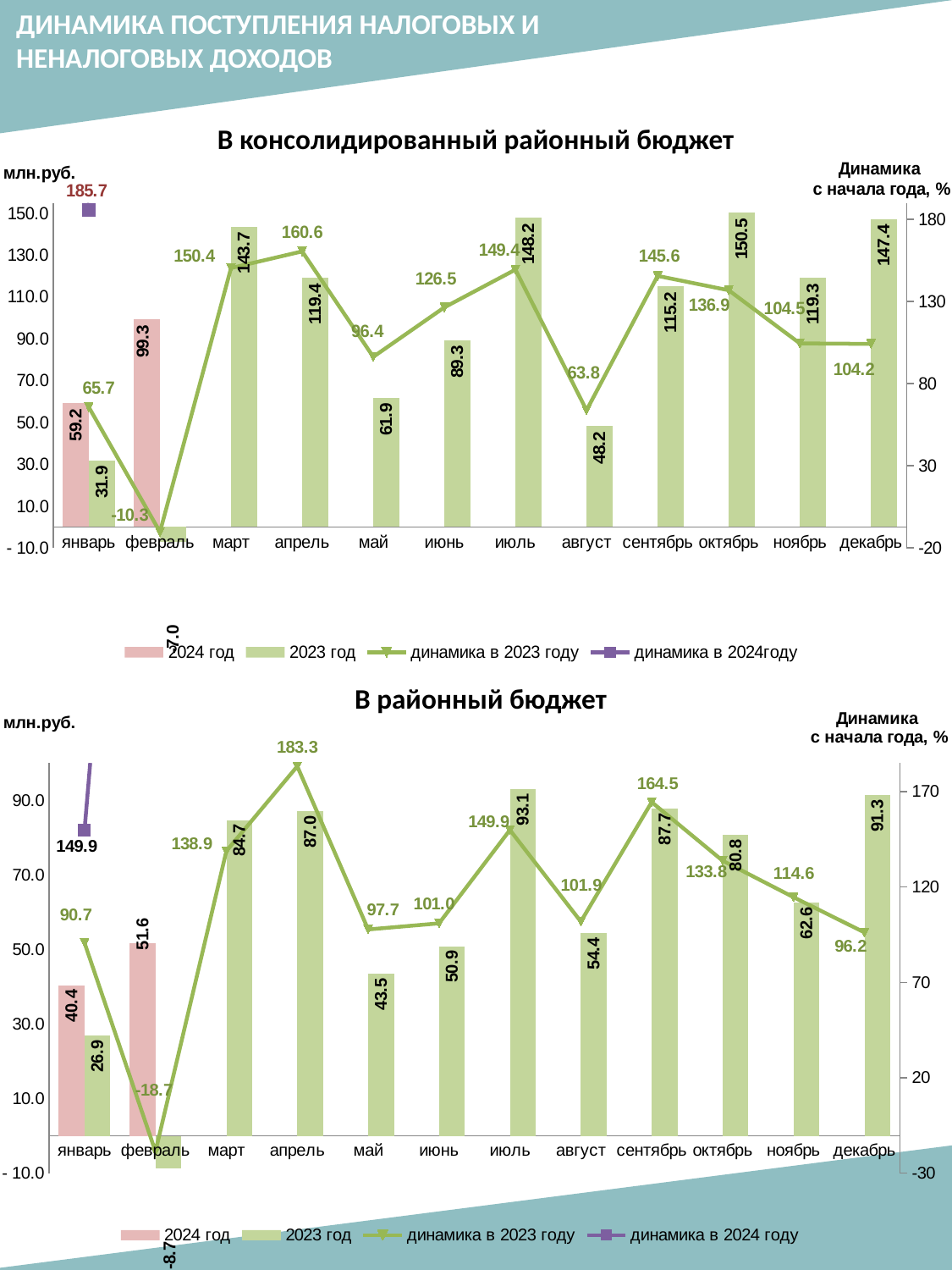
In the chart 'В районный бюджет', what is the value of the 2023 год bar for июль? 93.1 In the chart 'В районный бюджет', what is the difference between the 2024 год and 2023 год bars for февраль? 60.3 In the chart 'В районный бюджет', how many months are shown on the x axis? 12 In the chart 'В районный бюджет', what is the value of the 'динамика в 2024 году' marker for январь? 149.9 In the chart 'В консолидированный районный бюджет', how many series does the legend list? 4 In the chart 'В консолидированный районный бюджет', which month has the highest 2023 год bar? октябрь In the chart 'В консолидированный районный бюджет', what is the value of the 2023 год bar for октябрь? 150.5 In the chart 'В районный бюджет', which month has the lowest 'динамика в 2023 году' value? февраль In the chart 'В консолидированный районный бюджет', what is the difference between the 2024 год and 2023 год bars for январь? 27.3 In the chart 'В консолидированный районный бюджет', what is the value of the 'динамика в 2023 году' line for апрель? 160.6 In the chart 'В районный бюджет', which is larger: the 2023 год bar for май or for июнь? июнь In the chart 'В консолидированный районный бюджет', what is the value of the 2024 год bar for февраль? 99.3